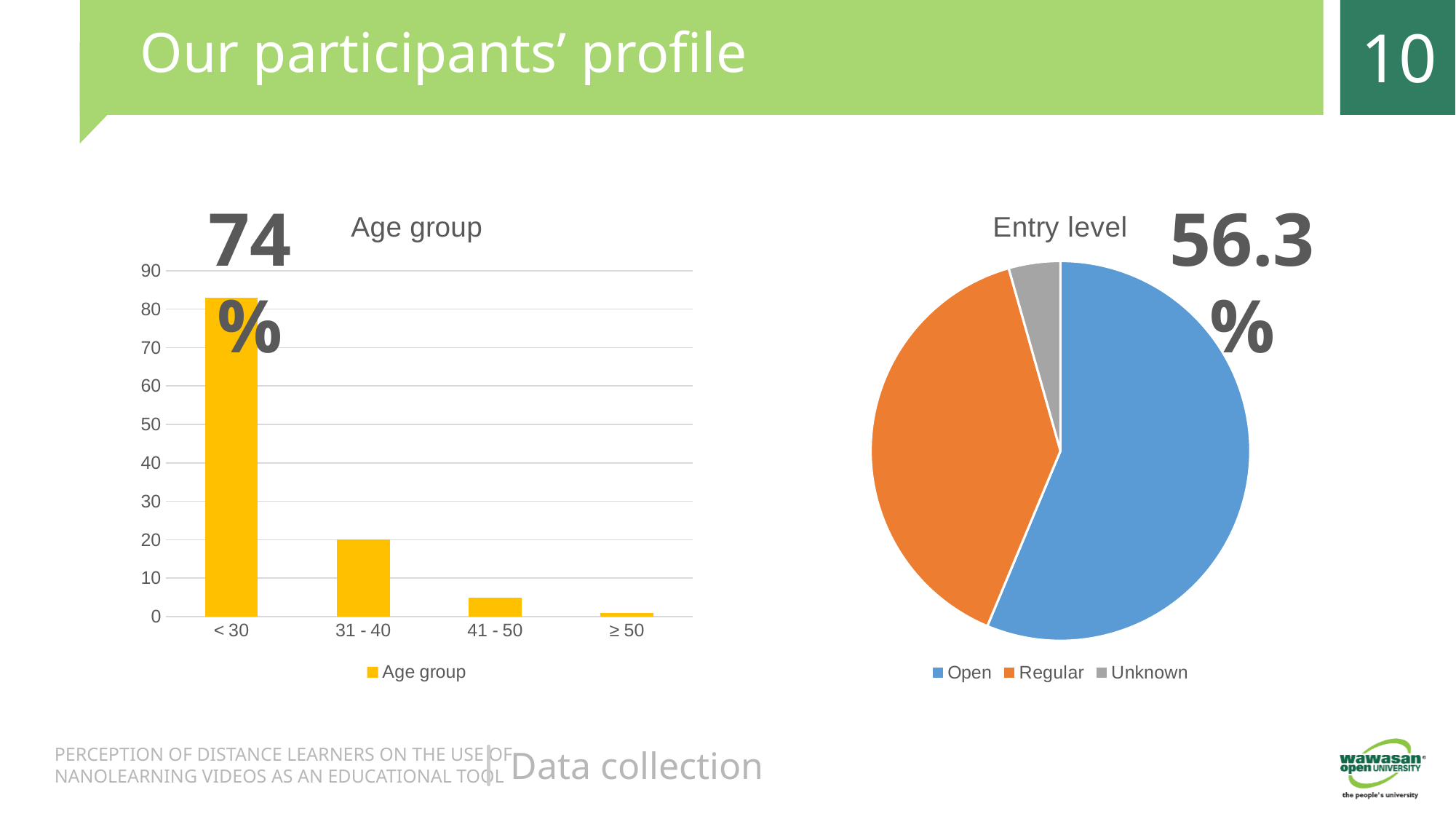
In the "Age group" chart, is the value for the 41 - 50 age group greater or less than 10? less In the "Age group" chart, do the values rise or fall moving from < 30 to ≥ 50 along the x axis? fall In the "Age group" chart, how many age group categories are shown on the x axis? 4 In the "Age group" chart, which is larger, the value for 31 - 40 or the value for 41 - 50? 31 - 40 In the "Entry level" pie chart, which category has the largest slice? Open What type of chart is the "Age group" chart on the left? bar chart In the "Age group" chart, what is the value for the 31 - 40 age group? 20 In the "Age group" chart, is the value for the < 30 age group greater or less than 70? greater In the "Entry level" pie chart, how many entries does the legend list? 3 In the "Age group" chart, which age group has the lowest bar? ≥ 50 What type of chart is the "Entry level" chart on the right? pie chart In the "Age group" chart, which age group has the highest bar? < 30